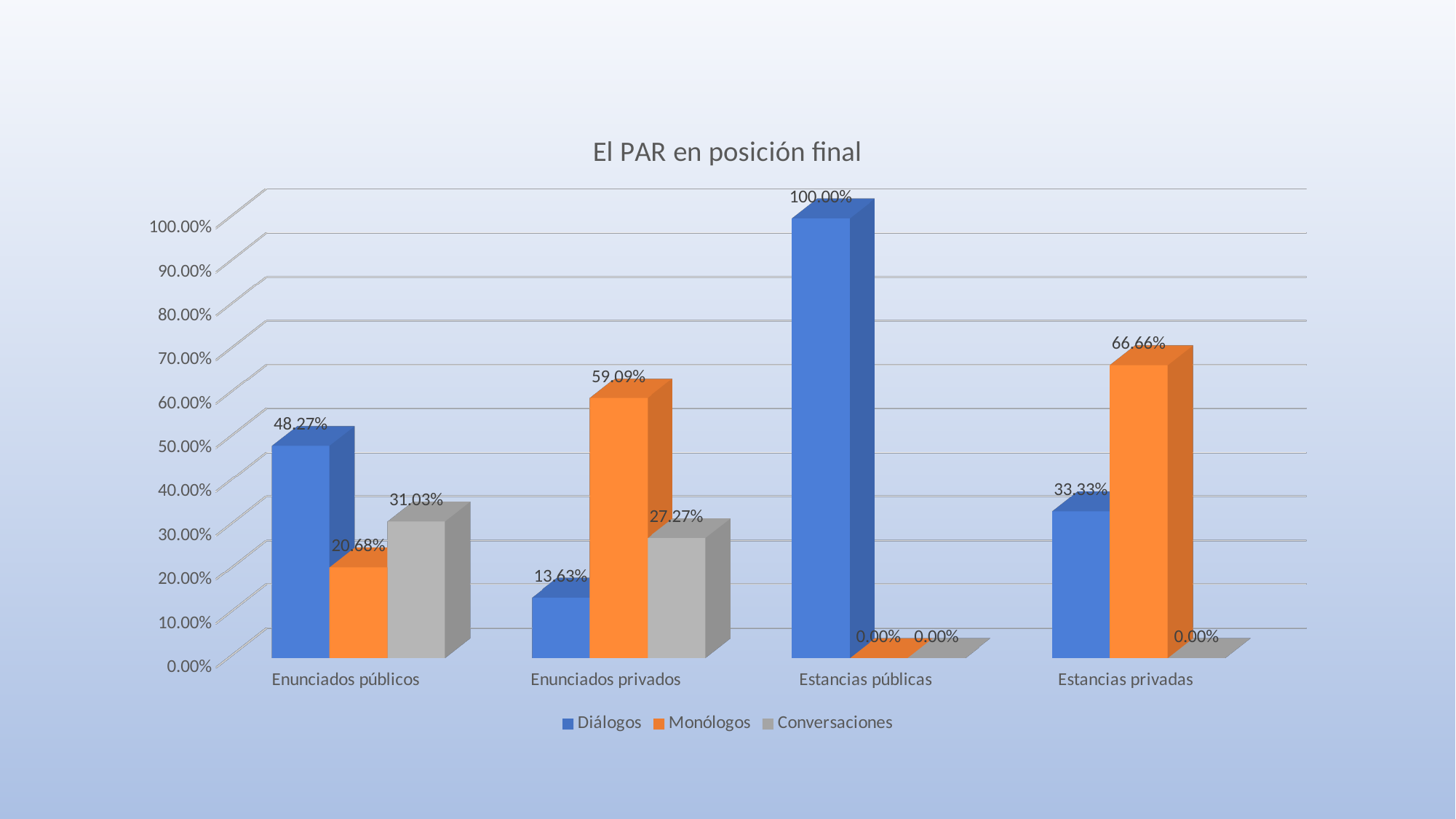
What is the title of the chart? El PAR en posición final What is the value for Monólogos in Enunciados privados? 59.09% What is the value for Diálogos in Enunciados públicos? 48.27% What kind of chart is shown on the slide? Bar chart How many categories are shown on the x axis? 4 What is the difference between Monólogos and Diálogos in Estancias privadas? 33.33% How many series does the legend list? 3 Which is larger in Enunciados públicos, Conversaciones or Monólogos? Conversaciones Is the value for Diálogos in Enunciados privados greater or less than 20.00%? less What is the value for Conversaciones in Estancias privadas? 0.00% Which category has the lowest value for Monólogos? Estancias públicas Which category has the highest value for Diálogos? Estancias públicas